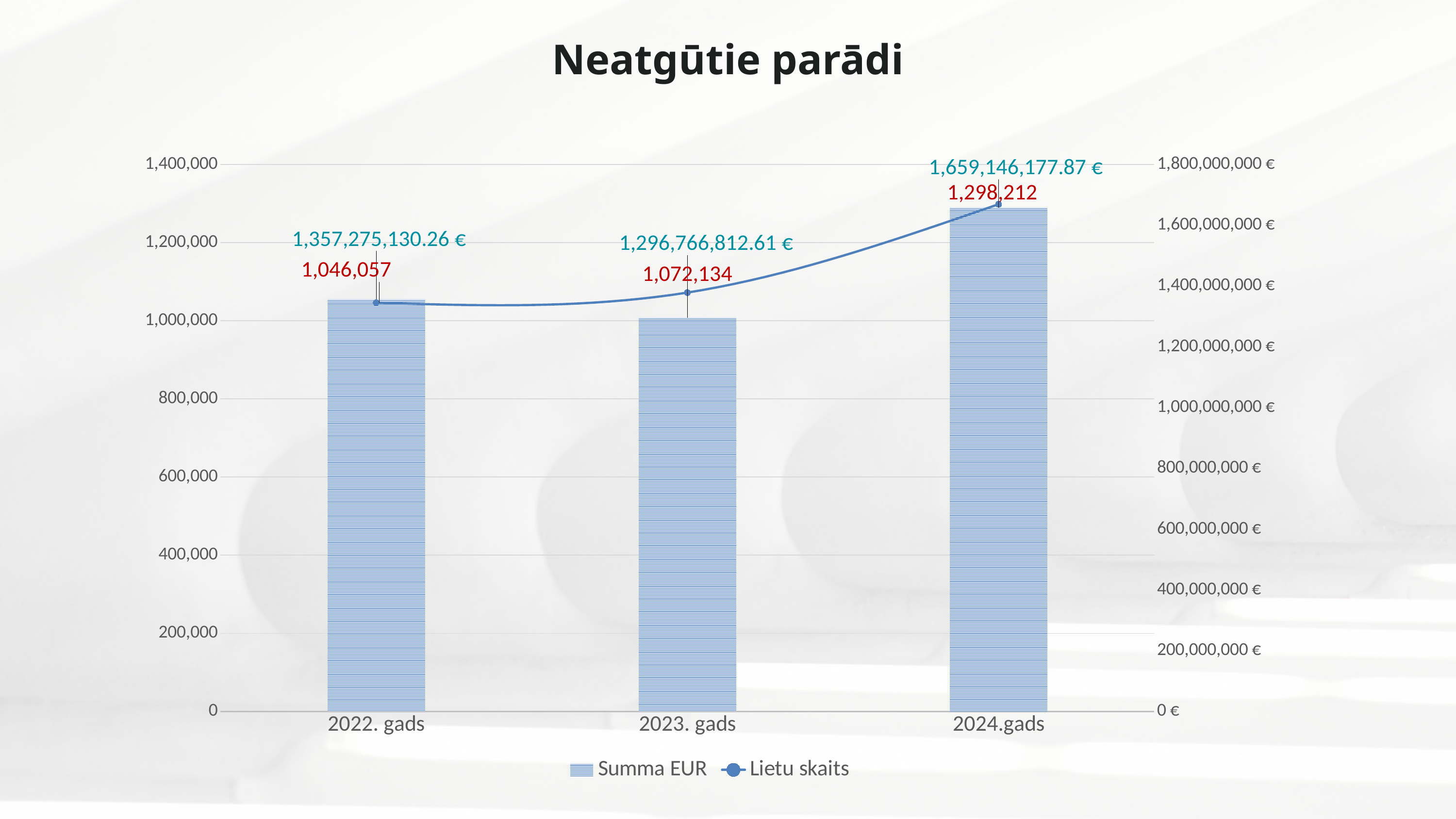
Which year has the highest Lietu skaits value? 2024.gads What is the difference in Summa EUR between 2022. gads and 2023. gads? 60,508,317.65 € How many series does the legend list? 2 Does the Lietu skaits series rise or fall from 2022. gads to 2024.gads? rise Which year has the lowest Summa EUR value? 2023. gads What is the title of the chart? Neatgūtie parādi What is the difference in Lietu skaits between 2024.gads and 2023. gads? 226,078 What is the Summa EUR value for 2023. gads? 1,296,766,812.61 € Which is larger, the Summa EUR value for 2022. gads or for 2023. gads? 2022. gads What is the Summa EUR value for 2024.gads? 1,659,146,177.87 € What is the Lietu skaits value for 2022. gads? 1,046,057 How many years are shown on the x axis? 3